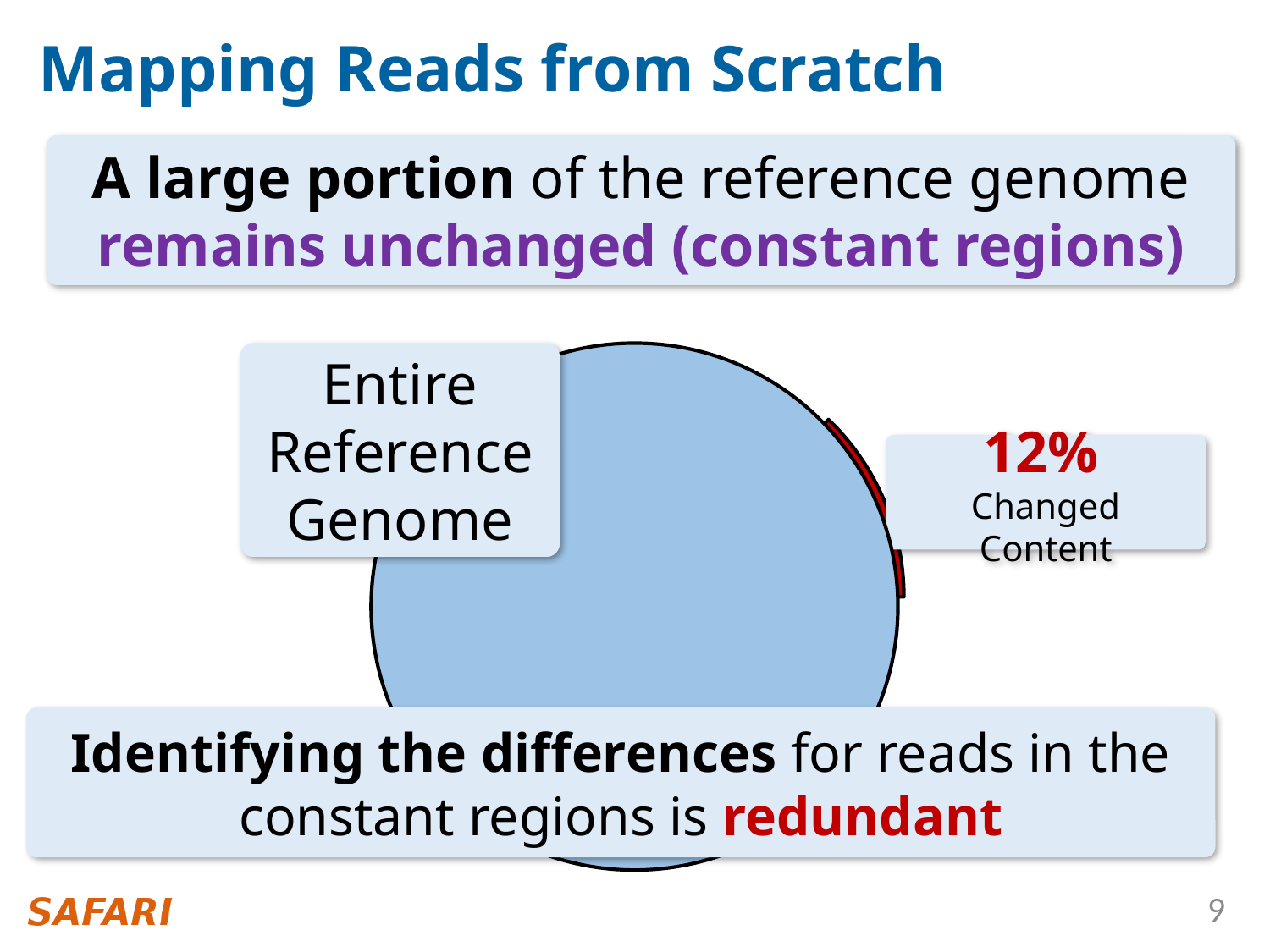
What share of the reference genome remains unchanged, given that 12% is changed content? 88% What does the whole circle of the pie chart represent? Entire Reference Genome Which is larger: the changed content slice or the unchanged remainder of the genome? the unchanged remainder What percentage of the reference genome is labelled as changed content? 12% What kind of chart is shown on the slide? pie chart What colour is the changed content slice of the pie chart? red How many slices does the pie chart have? 2 Is the share of changed content greater or less than 50%? less